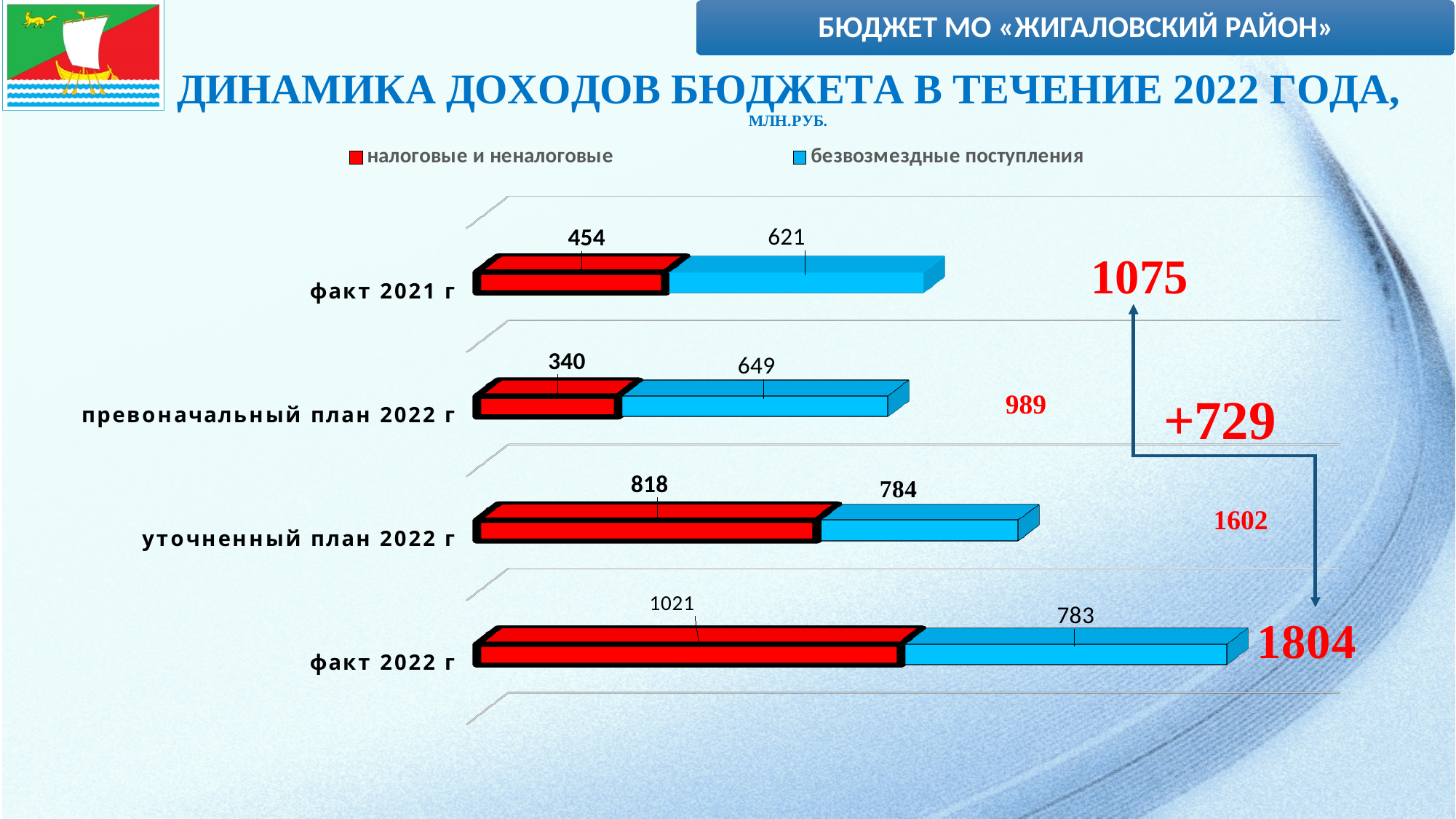
Which is larger for уточненный план 2022 г: налоговые и неналоговые or безвозмездные поступления? налоговые и неналоговые What is the value of безвозмездные поступления for факт 2022 г? 783 How many series does the legend list? 2 What is the value of налоговые и неналоговые for уточненный план 2022 г? 818 What is the value of налоговые и неналоговые for факт 2021 г? 454 Which category has the lowest value for налоговые и неналоговые? превоначальный план 2022 г What kind of chart is shown on the slide? stacked bar chart What is the total of the stacked bar for факт 2022 г? 1804 Which category has the highest value for налоговые и неналоговые? факт 2022 г How many categories are shown on the chart? 4 What is the difference between налоговые и неналоговые for факт 2022 г and факт 2021 г? 567 What is the value of безвозмездные поступления for превоначальный план 2022 г? 649